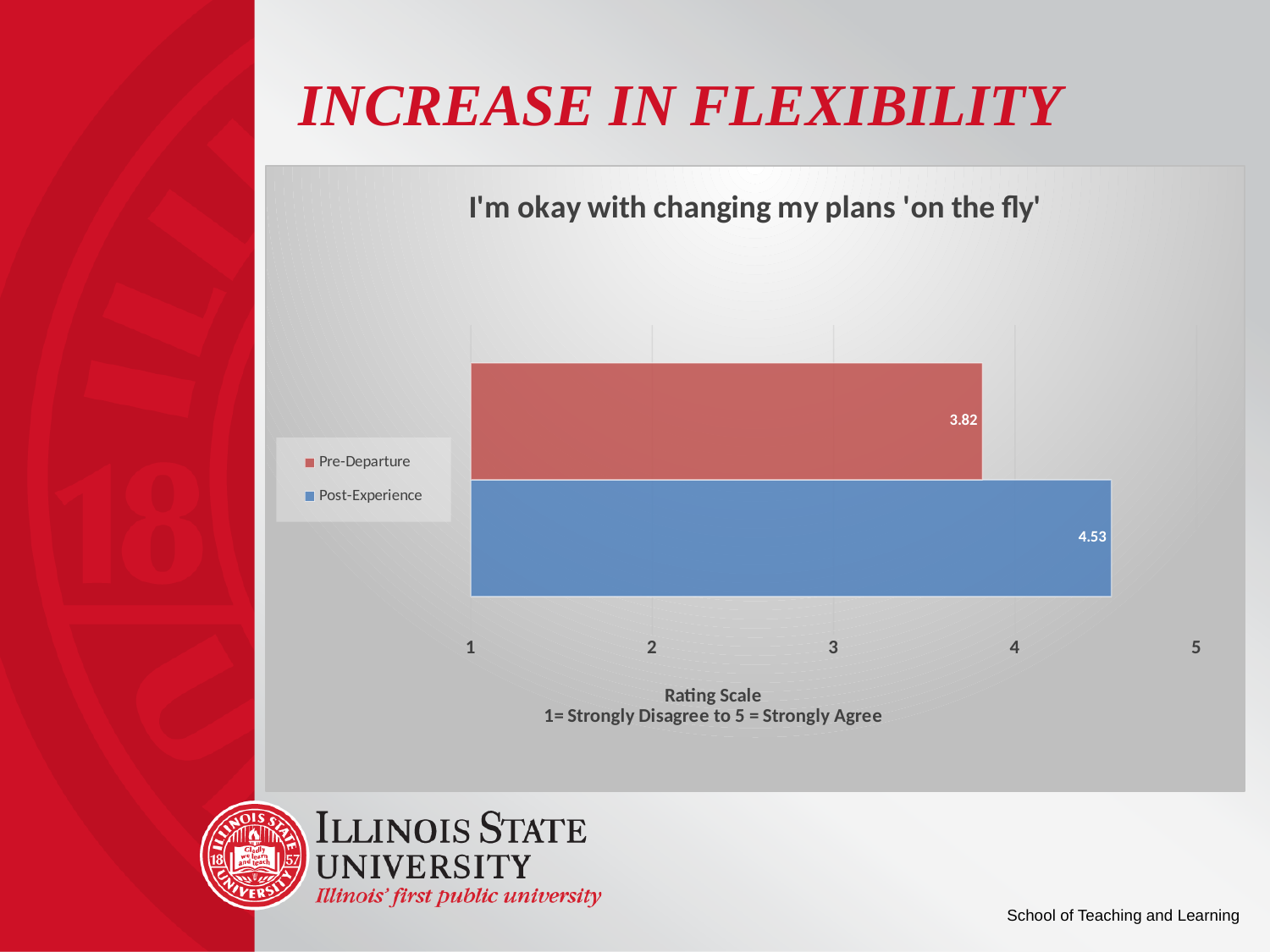
Is the value for Post-Experience greater or less than 4? greater How many series does the legend list? 2 What is the value for Post-Experience? 4.53 What is the difference between the Post-Experience and Pre-Departure values? 0.71 What is the value for Pre-Departure? 3.82 What is the highest value shown on the x axis? 5 Which series has the higher value, Pre-Departure or Post-Experience? Post-Experience What colour is the Post-Experience bar? blue Is the value for Pre-Departure greater or less than 4? less What is the title of the chart? I'm okay with changing my plans 'on the fly' What kind of chart is shown on the slide? bar chart Which series has the lowest value? Pre-Departure